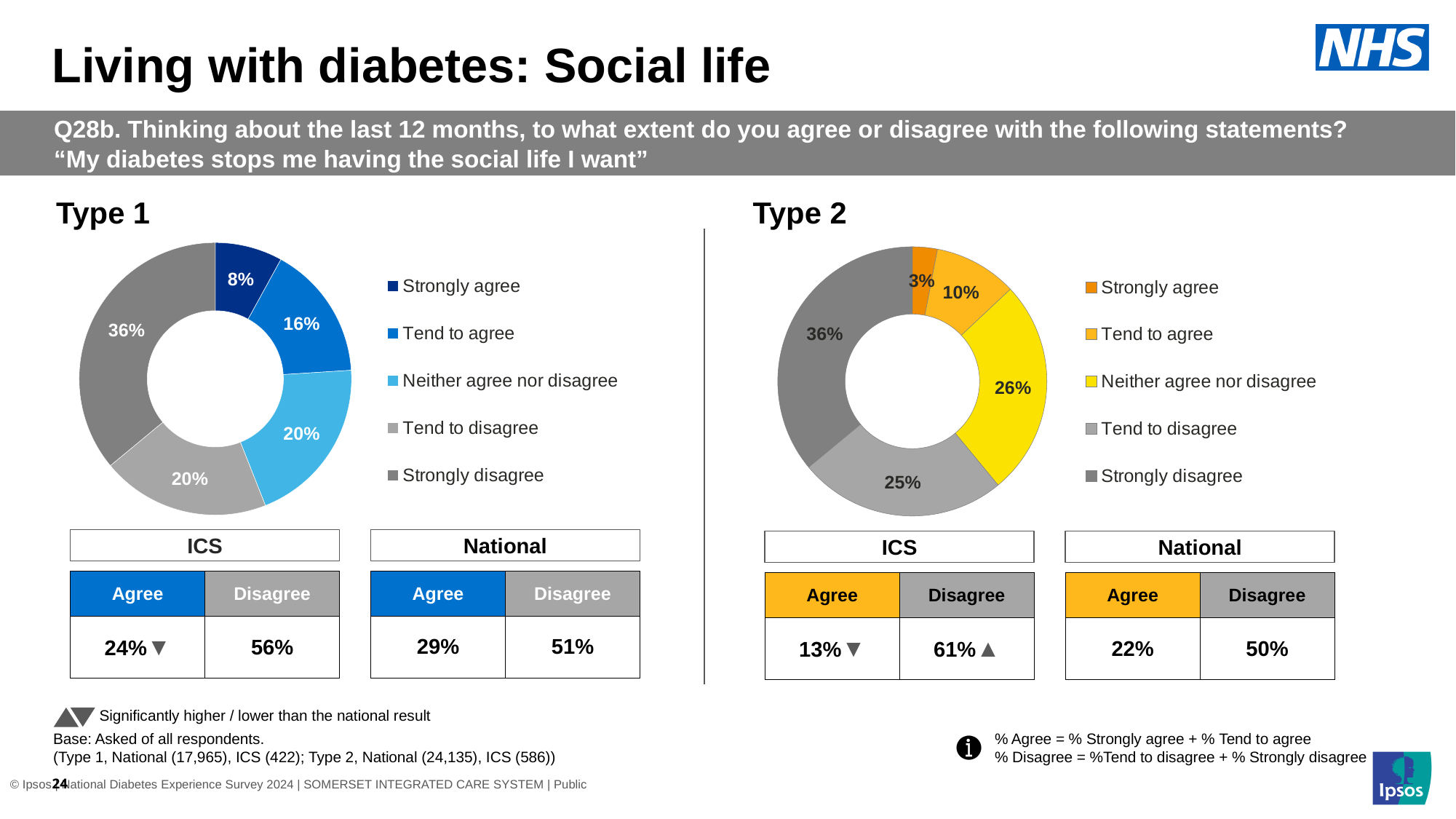
In the Type 1 chart, what percentage of respondents said 'Strongly agree'? 8% Which is larger in the Type 2 chart: the share for 'Neither agree nor disagree' or the share for 'Tend to agree'? Neither agree nor disagree In the Type 2 chart, which response category has the smallest share? Strongly agree How many response categories does the Type 1 chart show? 5 In the Type 1 chart, which response category has the largest share? Strongly disagree In the Type 1 chart, what percentage of respondents said 'Tend to agree'? 16% In the Type 2 chart, what colour represents 'Neither agree nor disagree'? Yellow In the Type 1 chart, what is the difference in percentage points between 'Strongly disagree' and 'Tend to agree'? 20 In the Type 2 chart, what is the difference in percentage points between 'Tend to disagree' and 'Tend to agree'? 15 In the Type 2 chart, which response category has the largest share? Strongly disagree What type of chart is used for the Type 2 results? Donut chart In the Type 2 chart, what percentage of respondents said 'Neither agree nor disagree'? 26%